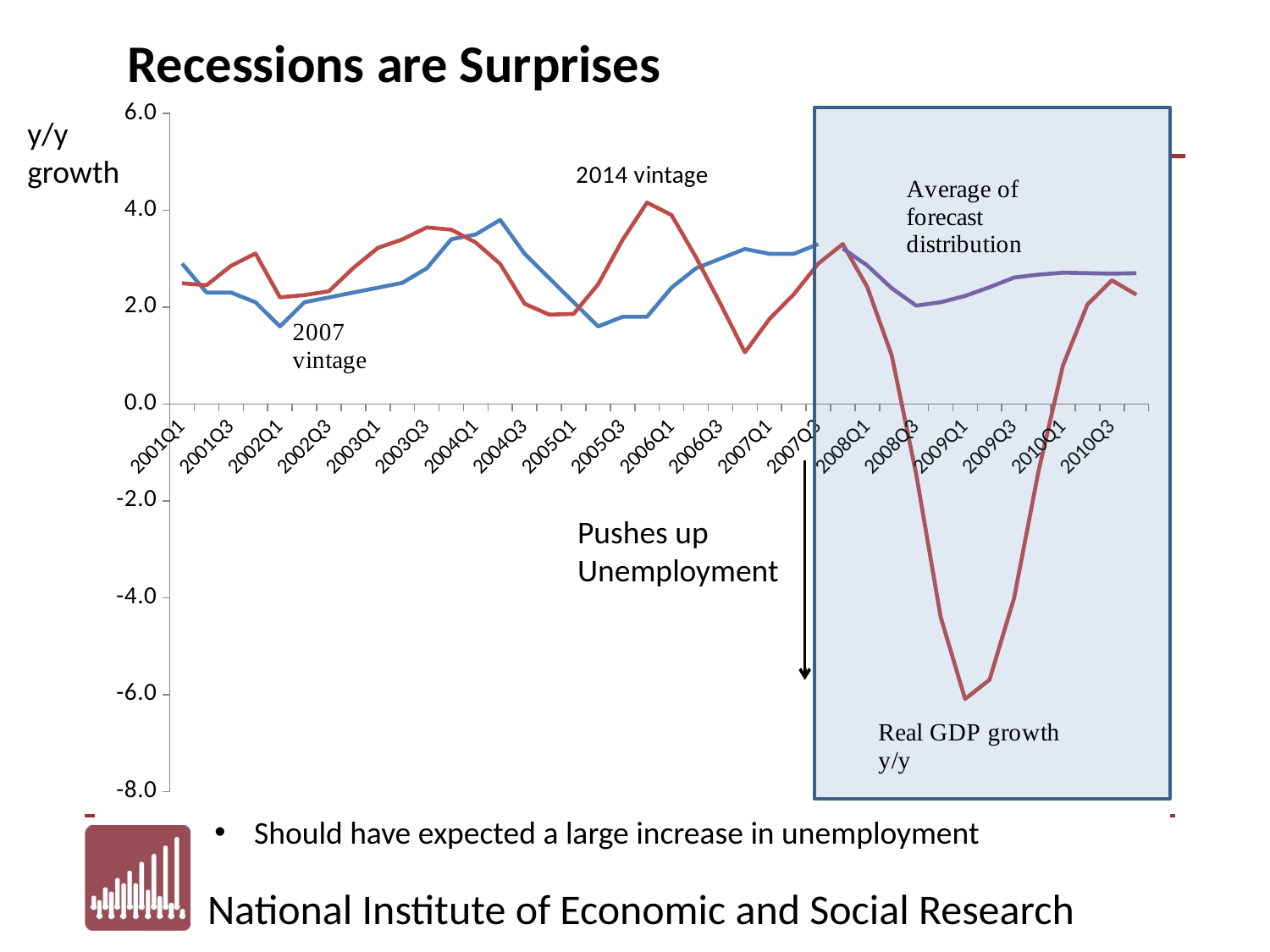
Is the value of the 2014 vintage series at 2007Q1 greater or less than 2.0? less How many data series are plotted on the chart? 3 What is the title of the slide's chart? Recessions are Surprises What kind of chart is shown on the slide? line chart At 2002Q1, which series is higher: the 2007 vintage or the 2014 vintage? 2014 vintage Does the 2014 vintage series rise or fall between 2008Q1 and 2009Q1? fall Is the value of the 2014 vintage series at 2006Q1 greater or less than 3.0? greater What label is given to the vertical axis of the chart? y/y growth Is the value of the 2007 vintage series at 2002Q1 greater or less than 2.0? less At which quarter does the 2014 vintage series reach its lowest value? 2009Q1 At 2009Q1, which series is higher: the Average of forecast distribution or the 2014 vintage? Average of forecast distribution